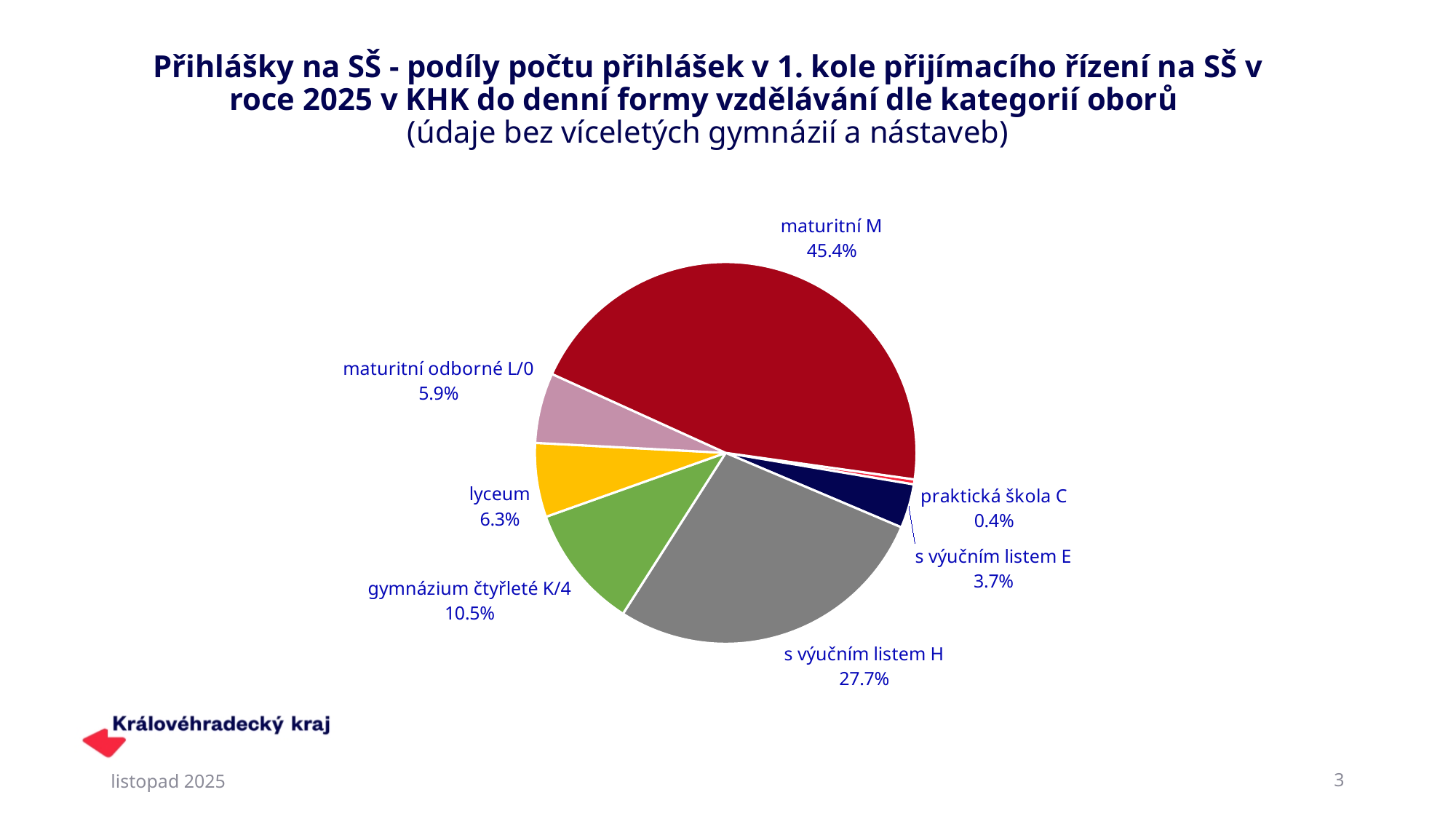
Which category has the largest slice of the pie? maturitní M What is the value shown for "s výučním listem H"? 27.7% What is the value shown for "gymnázium čtyřleté K/4"? 10.5% Which category has the smallest slice of the pie? praktická škola C What is the difference between the shares of "maturitní M" and "s výučním listem H"? 17.7% What kind of chart is shown on the slide? pie chart What share of the pie does the slice "maturitní M" represent? 45.4% How many slices does the pie chart have? 7 What is the value shown for "praktická škola C"? 0.4% Which is larger, the share for "lyceum" or the share for "maturitní odborné L/0"? lyceum What is the difference between the shares of "gymnázium čtyřleté K/4" and "s výučním listem E"? 6.8% What colour is the slice for "s výučním listem H"? grey